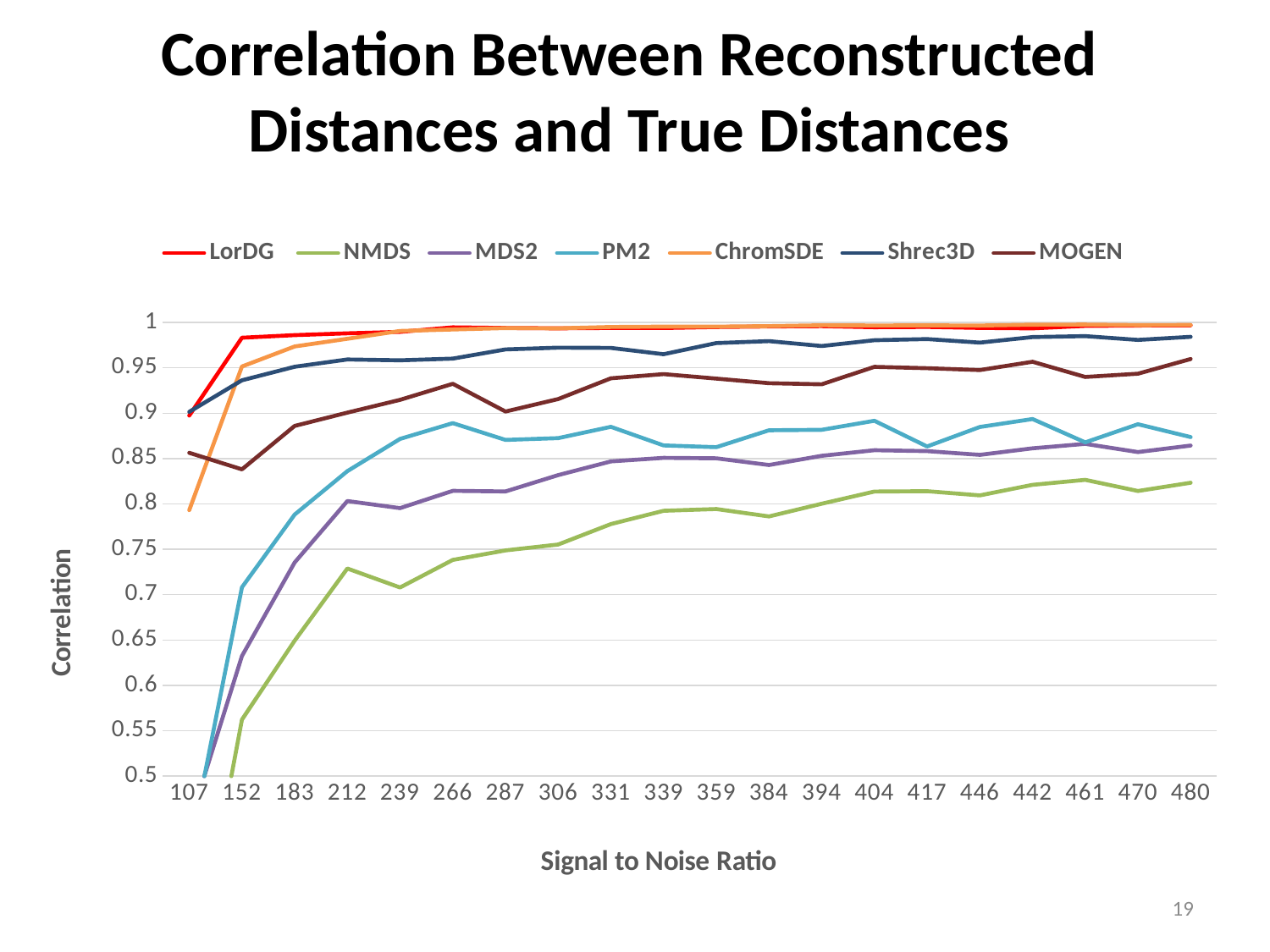
Is the value for ChromSDE at a signal-to-noise ratio of 107 greater or less than 0.85? less Which series has the lowest correlation at a signal-to-noise ratio of 212? NMDS What is the title of the chart? Correlation Between Reconstructed Distances and True Distances How many signal-to-noise ratio values are shown on the x axis? 20 Does the NMDS correlation generally rise or fall as the signal-to-noise ratio increases? rise What is the label of the x axis? Signal to Noise Ratio What kind of chart is shown on the slide? line chart How many series does the legend list? 7 Is the value for NMDS at a signal-to-noise ratio of 212 greater or less than 0.7? greater At a signal-to-noise ratio of 107, which is higher, Shrec3D or ChromSDE? Shrec3D Is the value for MOGEN at a signal-to-noise ratio of 152 greater or less than 0.8? greater